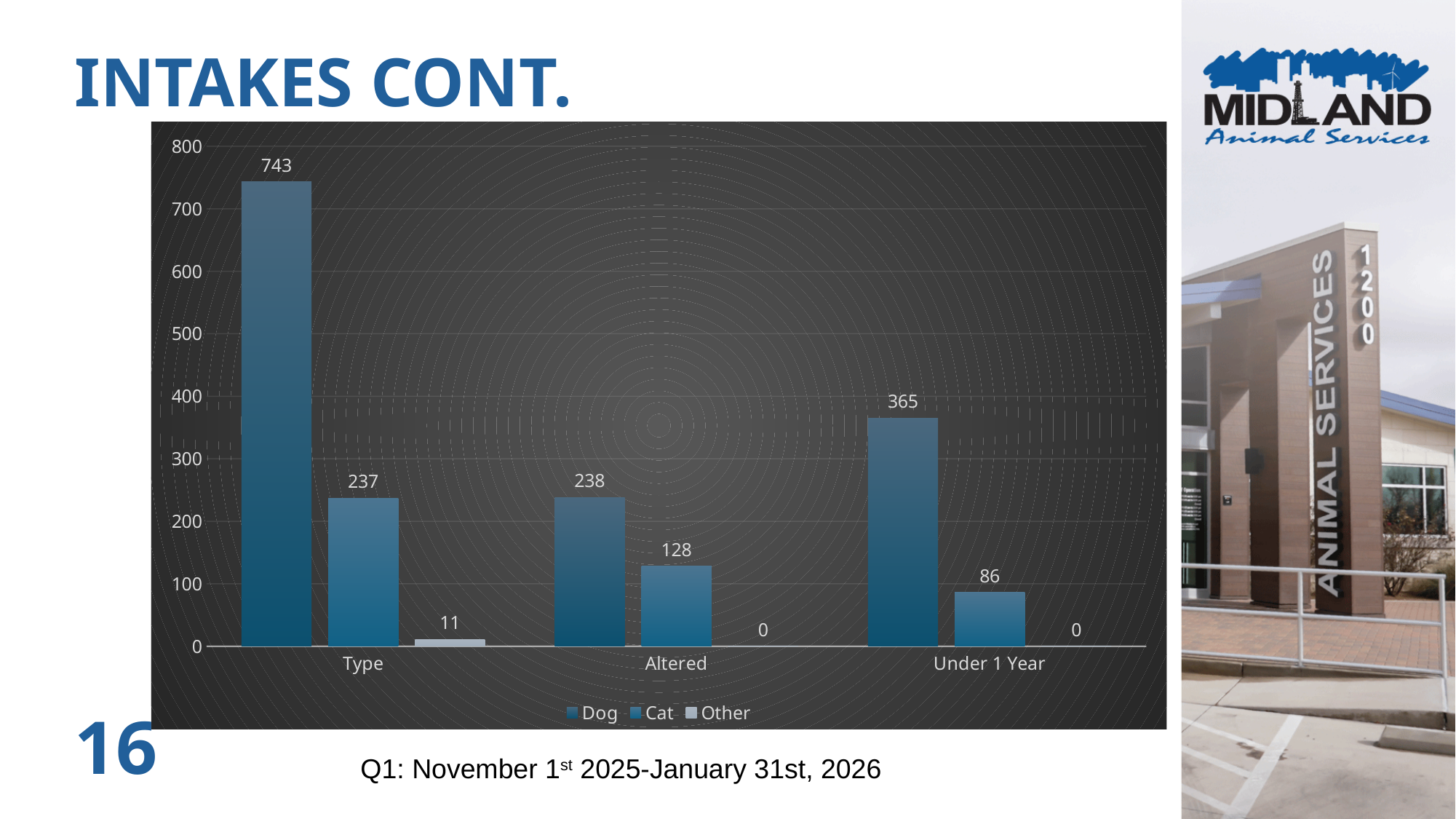
Which is larger, the Dog value for Under 1 Year or the Cat value for Type? Dog value for Under 1 Year How many series does the legend list? 3 What is the value for Dog in the Type category? 743 What is the value for Cat in the Under 1 Year category? 86 What is the title of the slide? INTAKES CONT. What is the difference between the Dog and Cat values in the Altered category? 110 What is the value for Other in the Type category? 11 Which category has the lowest Cat value? Under 1 Year What kind of chart is shown on the slide? Bar chart How many categories are shown on the x axis? 3 What is the value for Cat in the Altered category? 128 Which category has the highest Dog value? Type